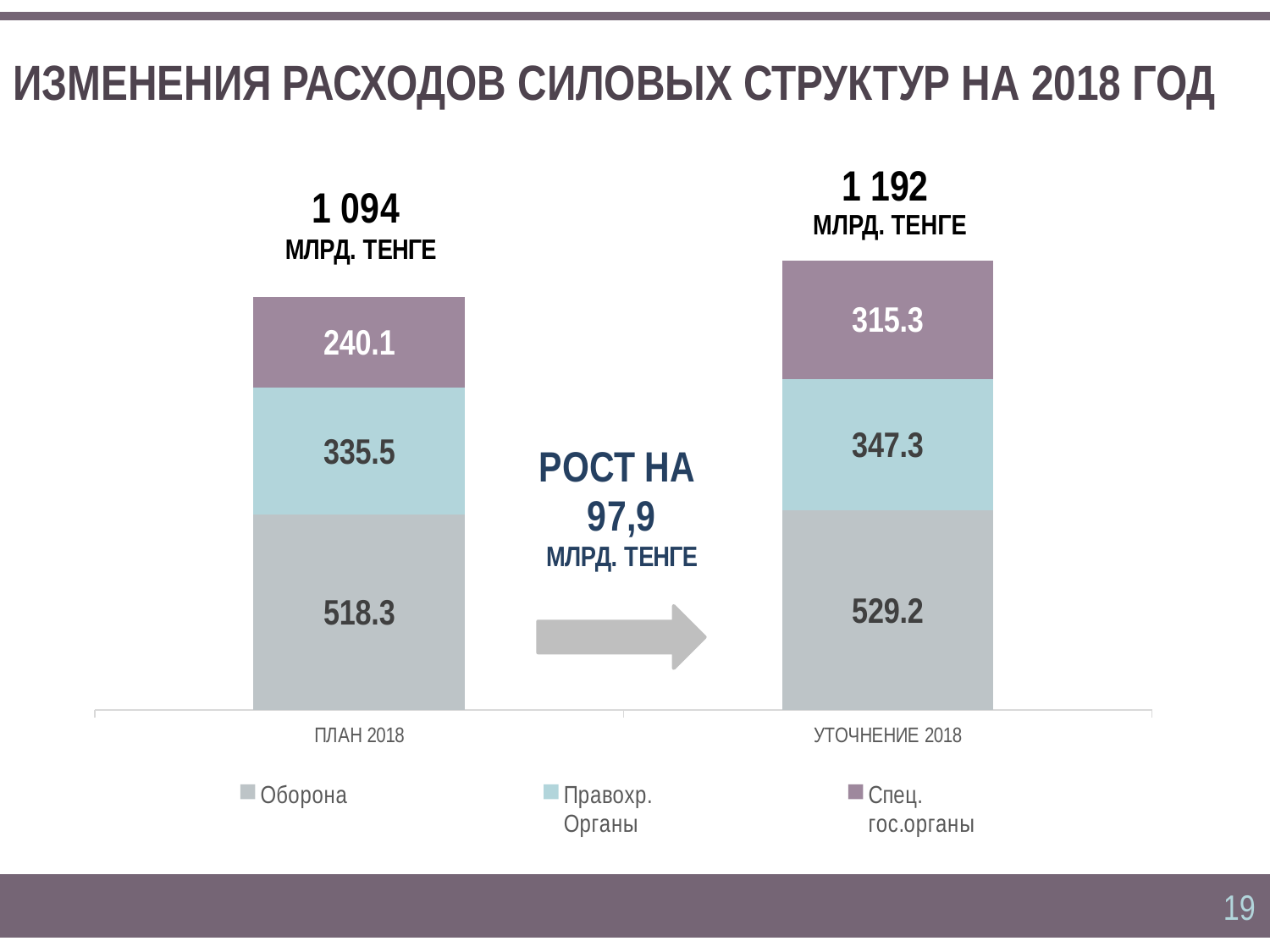
What is the value for Спец. гос.органы in УТОЧНЕНИЕ 2018? 315.3 What is the value for Оборона in ПЛАН 2018? 518.3 What is the difference between the Оборона values for УТОЧНЕНИЕ 2018 and ПЛАН 2018? 10.9 What is the difference between the Спец. гос.органы values for УТОЧНЕНИЕ 2018 and ПЛАН 2018? 75.2 Which series has the smallest value in УТОЧНЕНИЕ 2018? Спец. гос.органы What is the total of the stacked bar for ПЛАН 2018, as printed on the slide? 1 094 млрд. тенге Which series has the largest value in ПЛАН 2018? Оборона How many series does the legend list? 3 Which is larger: Правохр. Органы in ПЛАН 2018 or Правохр. Органы in УТОЧНЕНИЕ 2018? УТОЧНЕНИЕ 2018 What is the total of the stacked bar for УТОЧНЕНИЕ 2018, as printed on the slide? 1 192 млрд. тенге What kind of chart is shown on the slide? Stacked bar chart What is the value for Правохр. Органы in ПЛАН 2018? 335.5